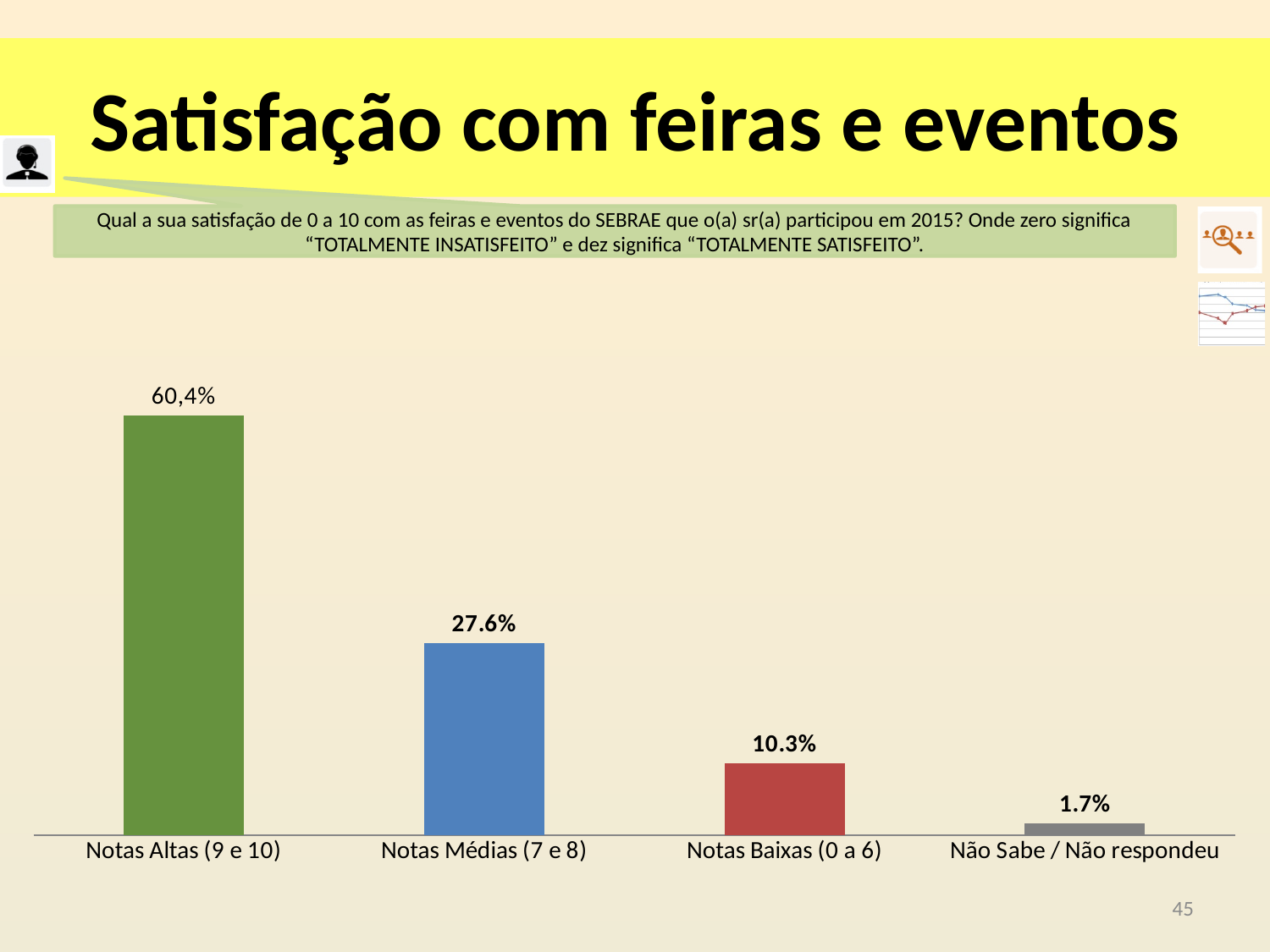
What is the value for Notas Altas (9 e 10)? 60,4% Which is larger, the value for Notas Médias (7 e 8) or the value for Notas Baixas (0 a 6)? Notas Médias (7 e 8) What is the value for Notas Baixas (0 a 6)? 10.3% What is the value for Não Sabe / Não respondeu? 1.7% What is the difference between the values for Notas Médias (7 e 8) and Notas Baixas (0 a 6)? 17.3% What is the difference between the values for Notas Baixas (0 a 6) and Não Sabe / Não respondeu? 8.6% Which category has the lowest value? Não Sabe / Não respondeu What is the value for Notas Médias (7 e 8)? 27.6% What kind of chart is shown on the slide? Bar chart How many categories are shown in the chart? 4 Do the values rise or fall from left to right across the categories? Fall Which category has the highest value? Notas Altas (9 e 10)